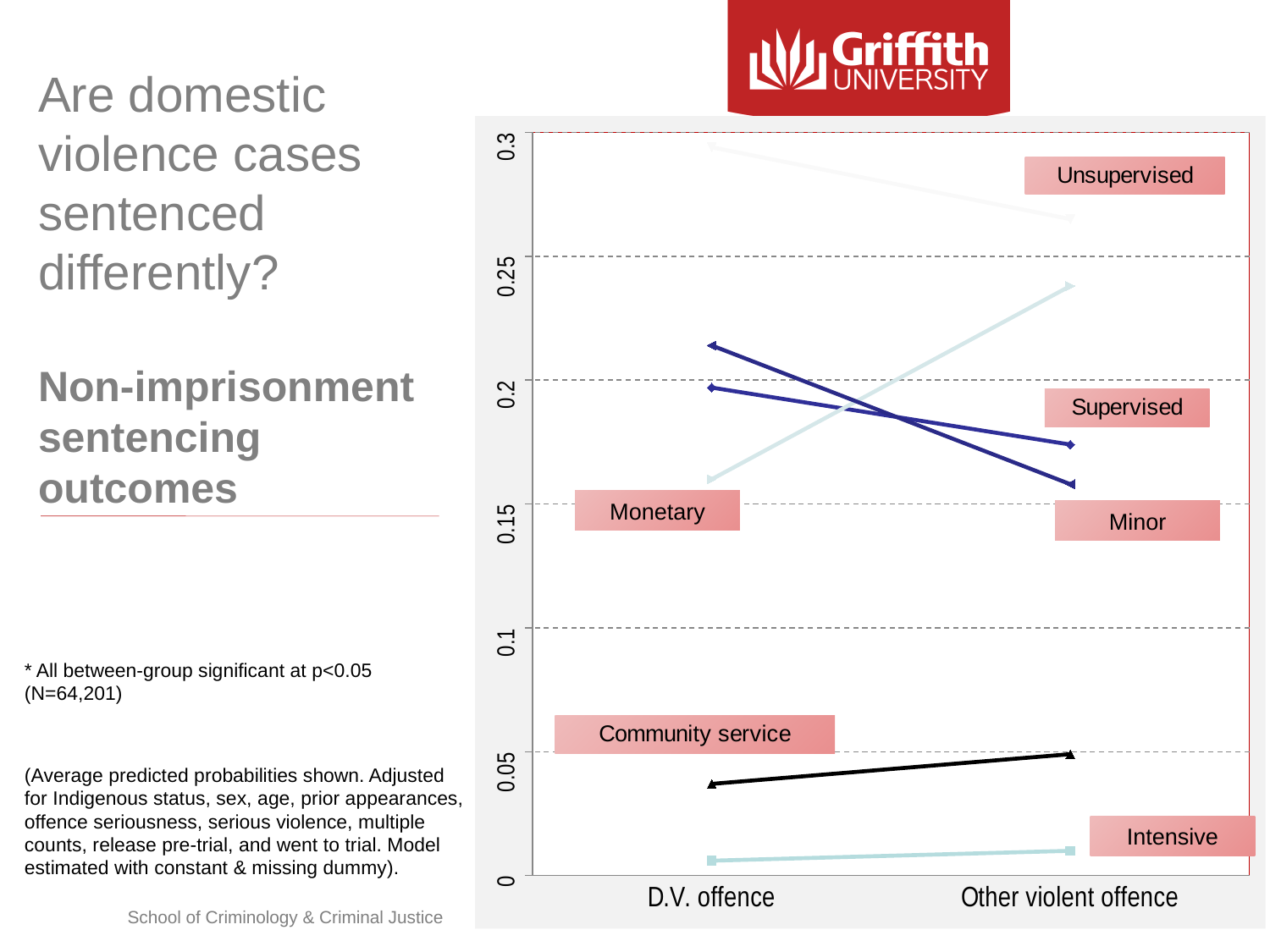
How many sentencing outcomes are labelled on the chart? 6 Is the value for Monetary at Other violent offence greater or less than 0.2? greater Does the Monetary line rise or fall from D.V. offence to Other violent offence? Rises Is the value for Unsupervised at D.V. offence greater or less than 0.25? greater Does the Community service line rise or fall from D.V. offence to Other violent offence? Rises Does the Unsupervised line rise or fall from D.V. offence to Other violent offence? Falls What kind of chart is shown on the slide? Line chart Which sentencing outcome has the highest value at D.V. offence? Unsupervised What are the two categories on the x axis of the chart? D.V. offence and Other violent offence How many offence categories are shown on the x axis of the chart? 2 Is the value for Monetary at D.V. offence greater or less than 0.2? less